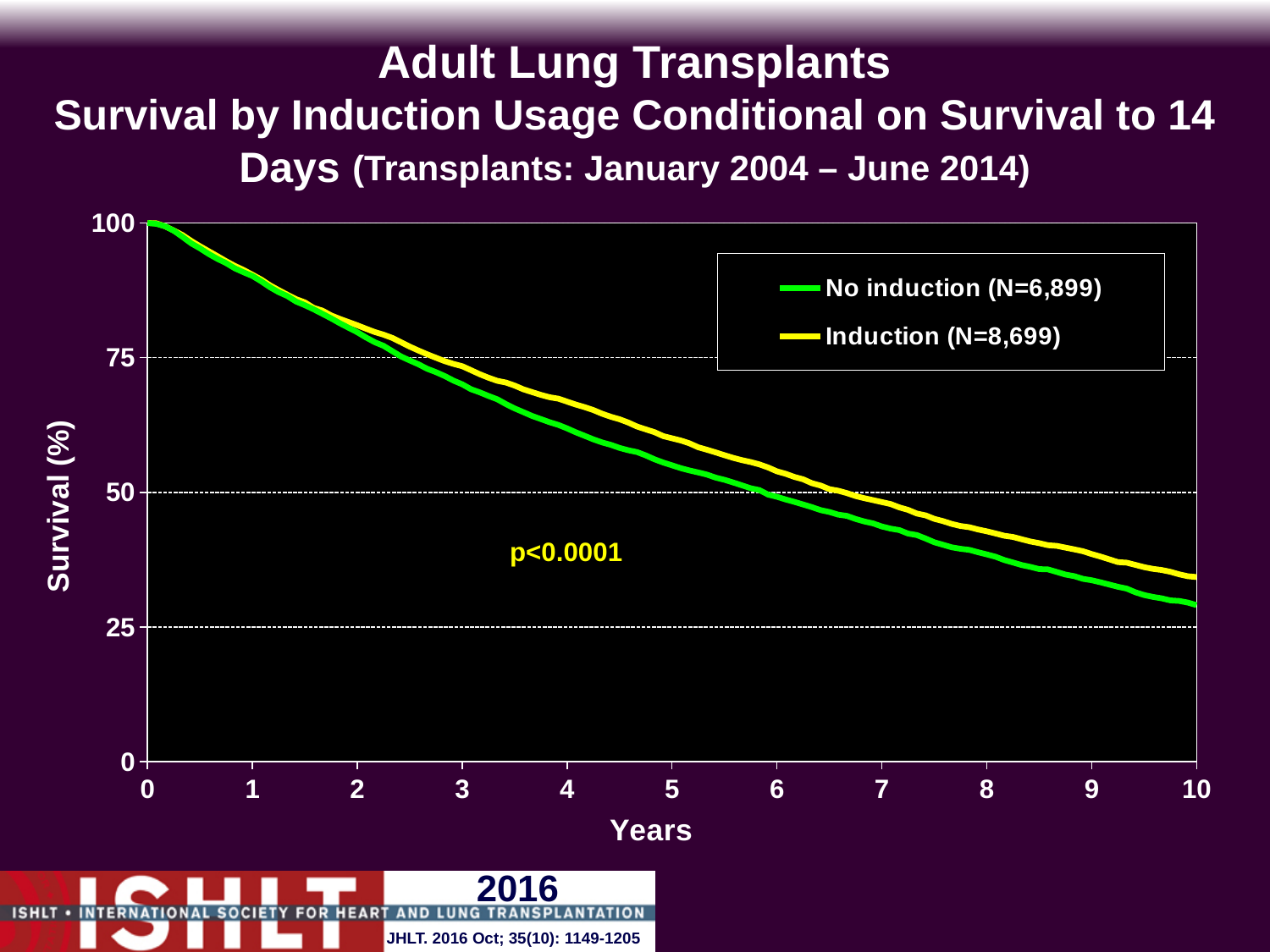
Do the survival curves rise or fall as years increase? fall Is the survival for Induction at 8 years greater or less than 50%? less At 5 years, which series has higher survival: Induction or No induction? Induction Is the survival for Induction at 2 years greater or less than 75%? greater What p-value is printed on the chart? p<0.0001 What is the N for the Induction group shown in the legend? N=8,699 What is the survival value for both series at 0 years? 100 What kind of chart is shown on the slide? line chart Is the survival for No induction at 10 years greater or less than 50%? less How many series does the legend list? 2 At 10 years, which series has lower survival? No induction